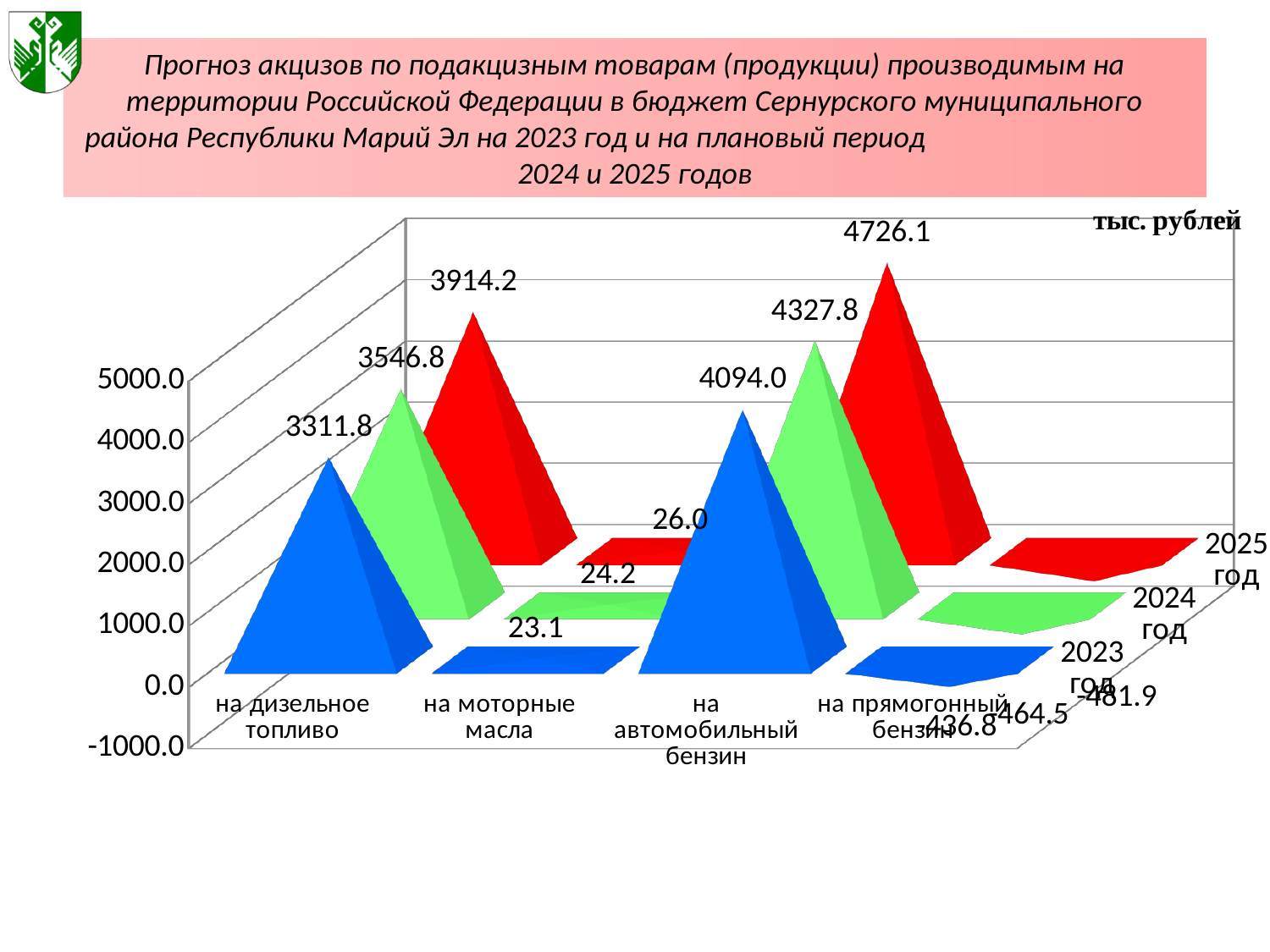
What is the difference between the 2025 год and 2024 год values for на дизельное топливо? 367.4 What is the difference between the 2025 год and 2023 год values for на автомобильный бензин? 632.1 Do the values for на дизельное топливо rise or fall from 2023 год to 2025 год? rise How many categories are shown on the x axis? 4 What is the value for на автомобильный бензин in 2025 год? 4726.1 How many series (years) does the chart show? 3 What is the value for на дизельное топливо in 2023 год? 3311.8 What is the value for на прямогонный бензин in 2025 год? -481.9 What is the value for на моторные масла in 2024 год? 24.2 In 2024 год, which is larger: на дизельное топливо or на автомобильный бензин? на автомобильный бензин Which category has the lowest value in 2024 год? на прямогонный бензин Which category has the highest value in 2025 год? на автомобильный бензин